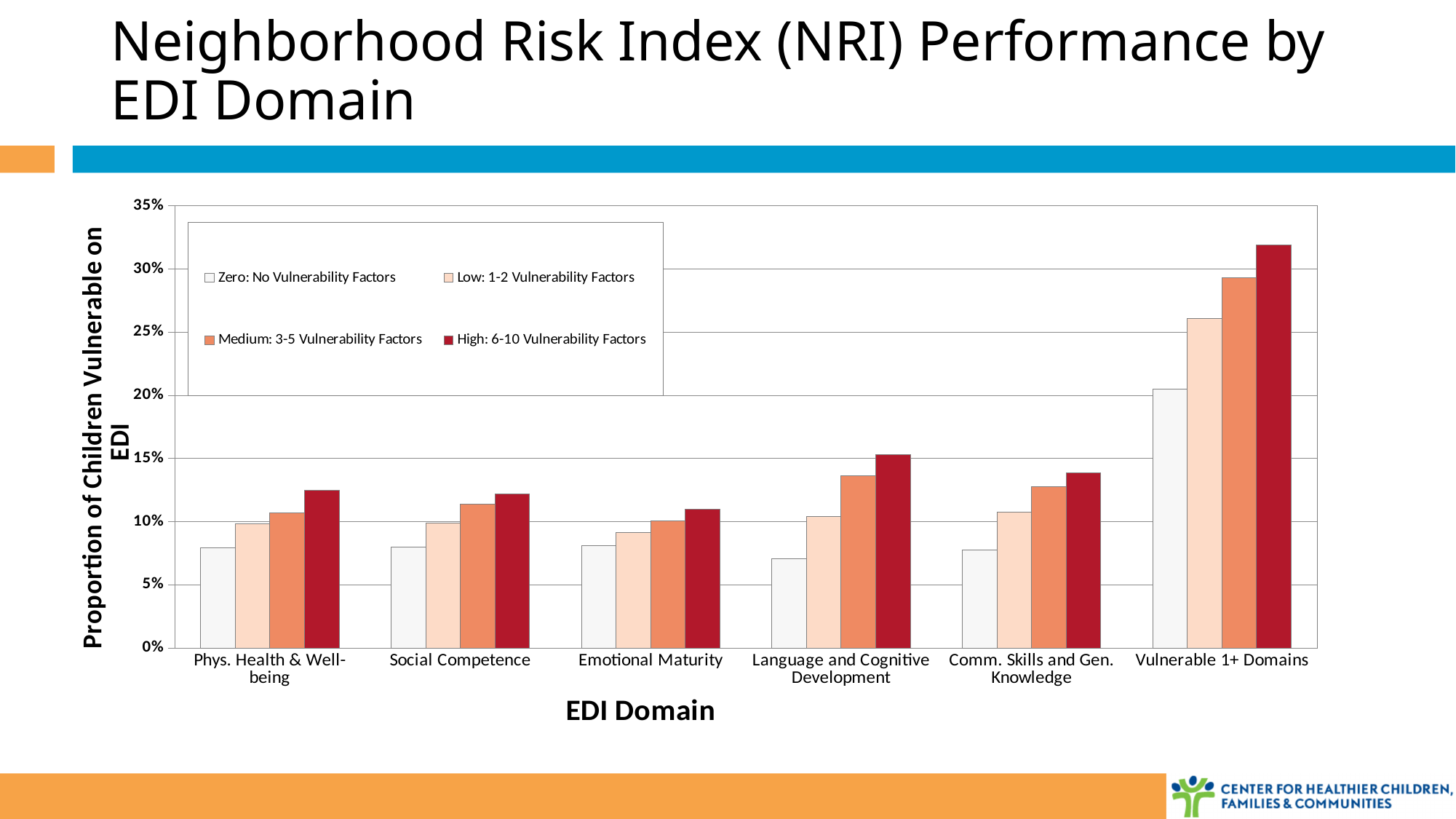
What is the title of the y axis? Proportion of Children Vulnerable on EDI Is the value for Medium: 3-5 Vulnerability Factors in Language and Cognitive Development greater or less than 15%? less Is the value for Zero: No Vulnerability Factors in Social Competence greater or less than 10%? less How many EDI domain categories are shown on the x axis? 6 Which EDI domain has the lowest value for the Zero: No Vulnerability Factors series? Language and Cognitive Development Is the value for High: 6-10 Vulnerability Factors in Vulnerable 1+ Domains greater or less than 30%? greater How many series does the legend list? 4 What kind of chart is shown on the slide? bar chart Which EDI domain has the highest value for the High: 6-10 Vulnerability Factors series? Vulnerable 1+ Domains Which is larger: the High: 6-10 Vulnerability Factors value for Phys. Health & Well-being or for Emotional Maturity? Phys. Health & Well-being Within each EDI domain, do the values rise or fall going from the Zero series to the High series? rise